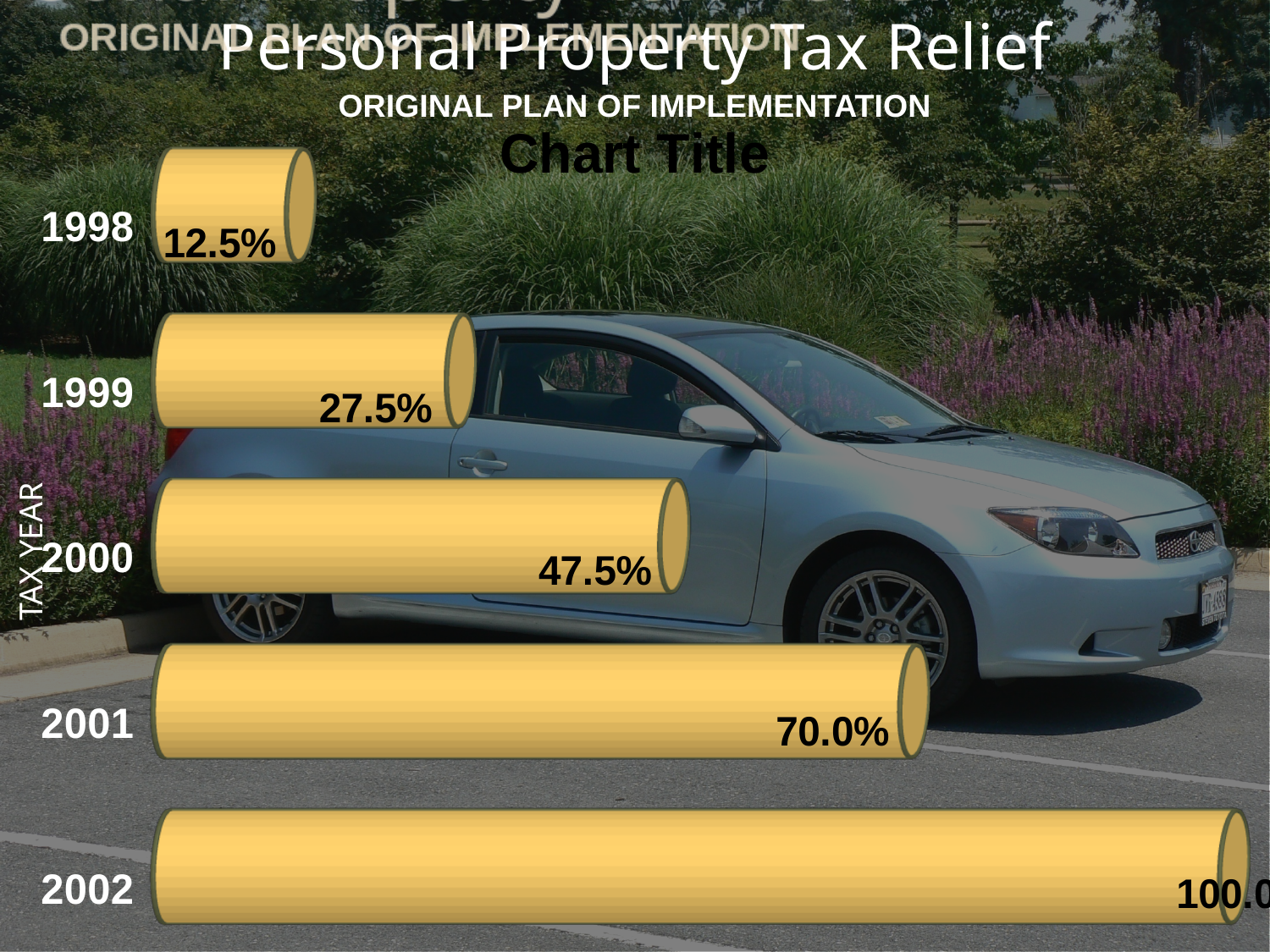
How many tax years are shown in the chart? 5 What is the difference between the values for 1999 and 1998? 15.0% What is the value for 2001? 70.0% What is the value for 1998? 12.5% Which is larger, the value for 2000 or the value for 1999? 2000 What is the difference between the values for 2001 and 2000? 22.5% What kind of chart is shown on the slide? bar chart Do the values rise or fall from 1998 to 2002? rise Which tax year has the highest value? 2002 What is the value for 1999? 27.5% What is the value for 2000? 47.5% Which tax year has the lowest value? 1998